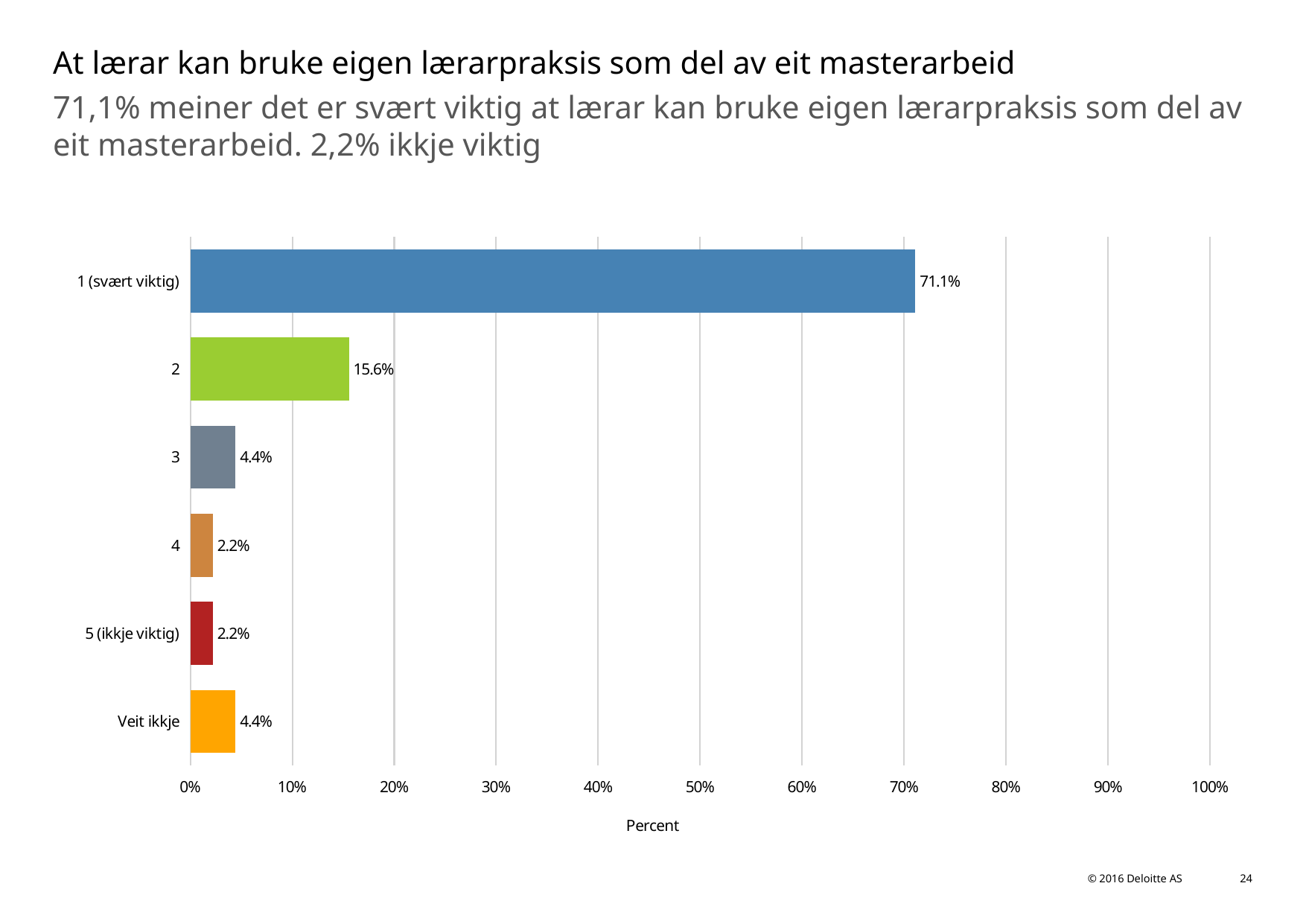
What is the value for "5 (ikkje viktig)"? 2.2% Which is larger, the value for "2" or the value for "3"? 2 What is the label of the horizontal axis? Percent What is the value for category "2"? 15.6% Is the value for "1 (svært viktig)" greater or less than 70%? greater What is the value for "1 (svært viktig)"? 71.1% Which category has the highest value? 1 (svært viktig) What kind of chart is shown on the slide? Bar chart What is the value for "Veit ikkje"? 4.4% What is the difference between the values for "3" and "4"? 2.2% What is the difference between the values for "1 (svært viktig)" and "2"? 55.5% How many categories are shown in the chart? 6